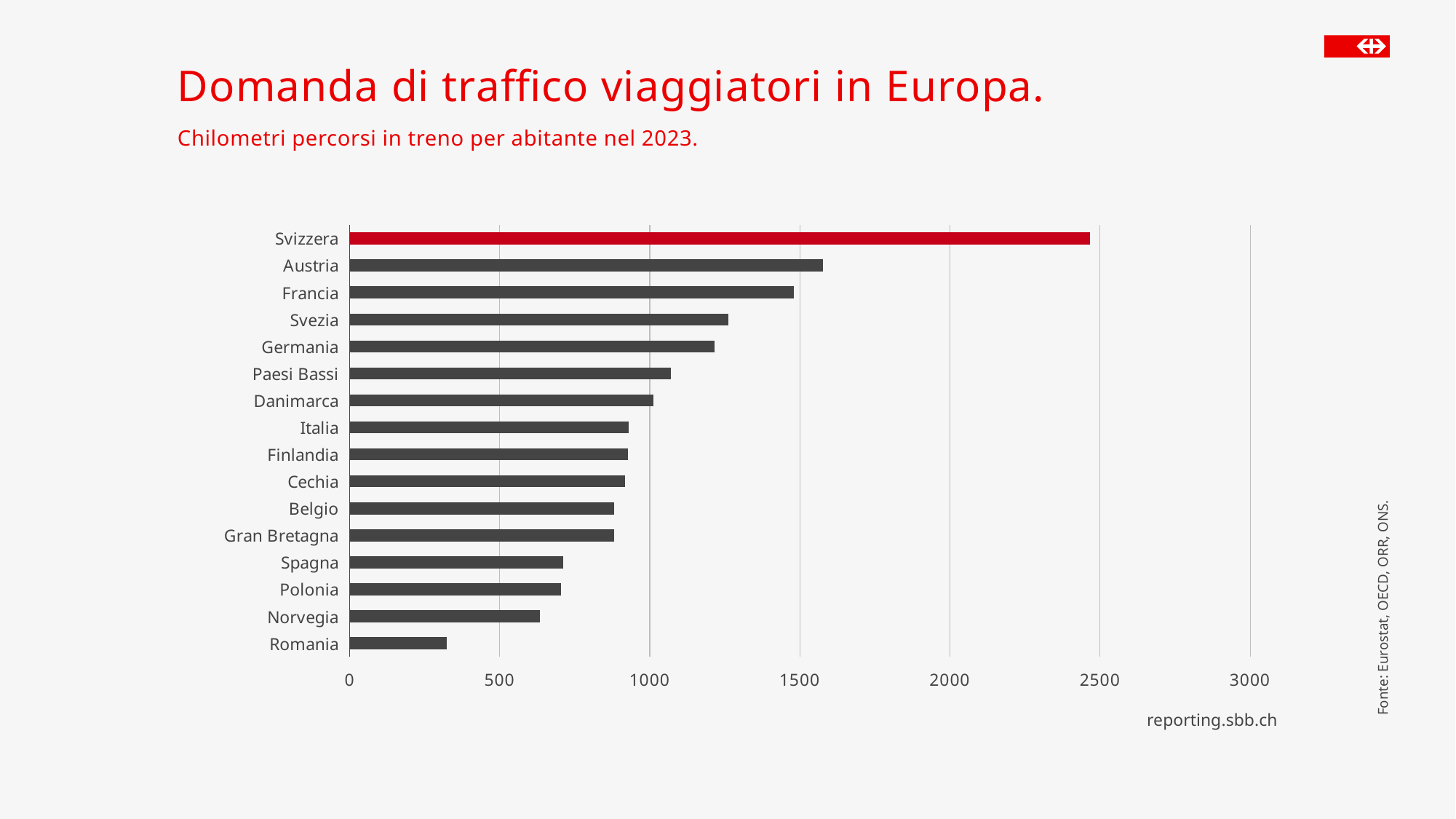
Is the value for Austria greater or less than 1500? greater Which country has the highest value in the chart? Svizzera How many countries are shown in the chart? 16 Which country has the lowest value in the chart? Romania Is the value for Romania greater or less than 500? less Which has a larger value, Francia or Svezia? Francia Which bar in the chart is coloured red rather than dark grey? Svizzera Is the value for Germania greater or less than 1000? greater What kind of chart is shown on the slide? bar chart Which has a larger value, Norvegia or Romania? Norvegia